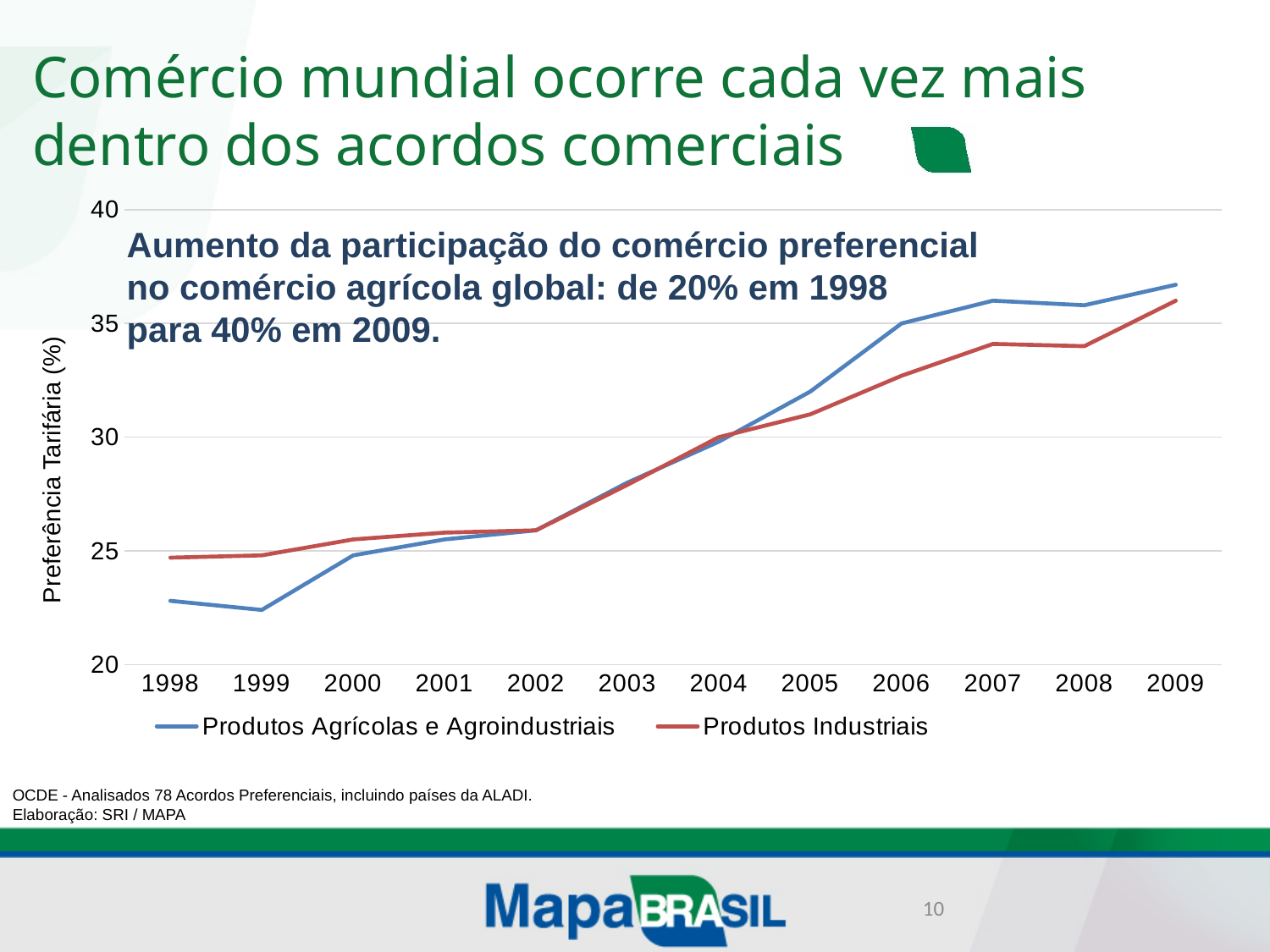
Is the value for Produtos Agrícolas e Agroindustriais in 2006 greater or less than 30? greater In 2007, which series has the higher value, Produtos Agrícolas e Agroindustriais or Produtos Industriais? Produtos Agrícolas e Agroindustriais Is the value for Produtos Industriais in 2009 greater or less than 35? greater Do the values for Produtos Agrícolas e Agroindustriais rise or fall from 1998 to 2009? rise How many series does the legend list? 2 Is the value for Produtos Agrícolas e Agroindustriais in 1998 greater or less than 25? less In which year does Produtos Industriais reach its highest value? 2009 What is the label of the y axis? Preferência Tarifária (%) In 1998, which series has the higher value, Produtos Agrícolas e Agroindustriais or Produtos Industriais? Produtos Industriais How many years are shown on the x axis? 12 What kind of chart is shown on the slide? line chart